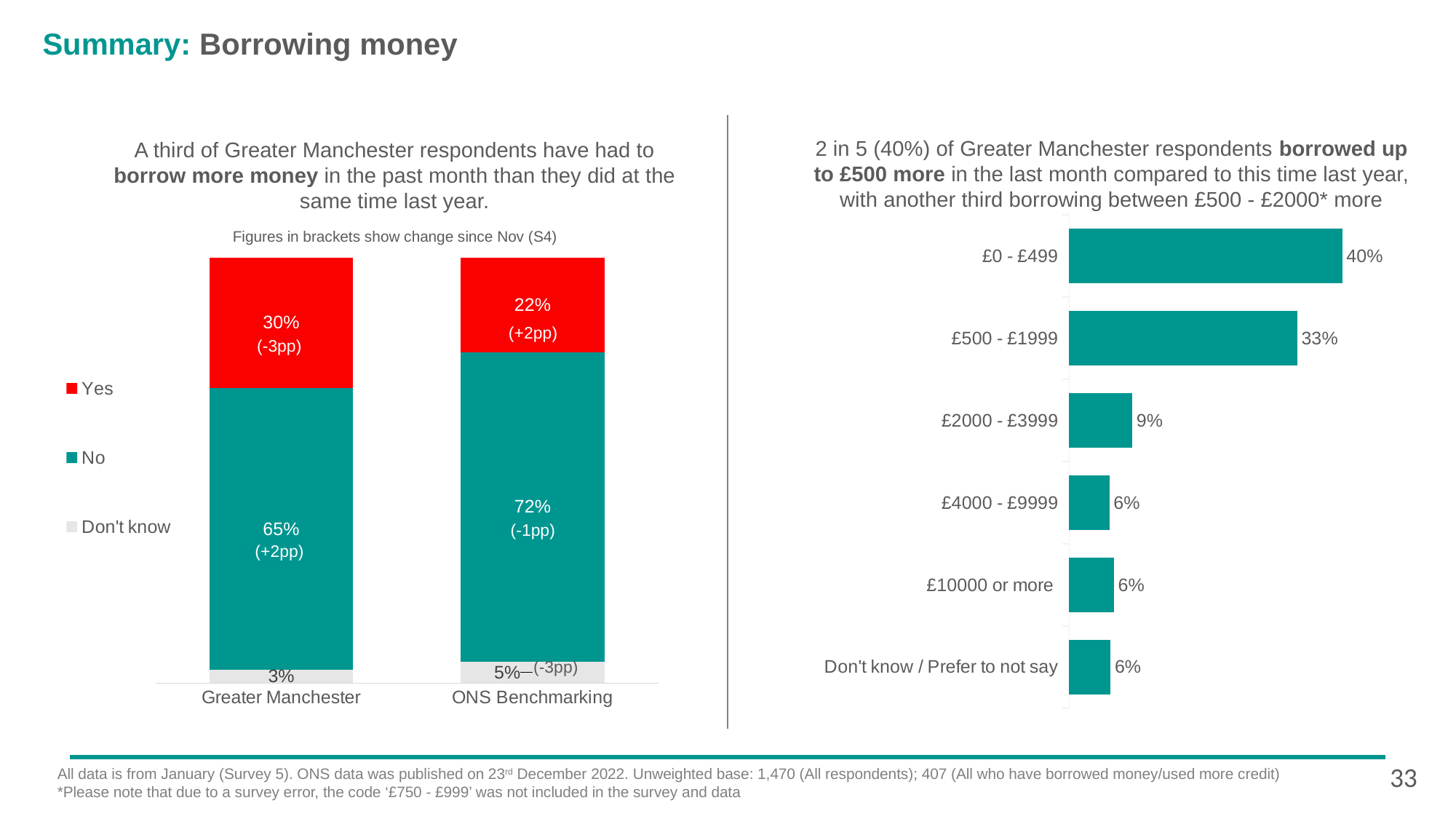
What type of chart is shown on the right of the slide? Bar chart In the stacked bar chart on the left, what is the Don't know percentage for ONS Benchmarking? 5% In the stacked bar chart on the left, which group has the larger Yes percentage, Greater Manchester or ONS Benchmarking? Greater Manchester In the bar chart on the right, what is the difference between the £0 - £499 and £500 - £1999 values? 7 percentage points In the bar chart on the right, how many categories are shown? 6 In the stacked bar chart on the left, what percentage of ONS Benchmarking respondents answered No? 72% In the bar chart on the right, what percentage of respondents borrowed £0 - £499 more? 40% In the bar chart on the right, which category has the highest value? £0 - £499 In the stacked bar chart on the left, what percentage of Greater Manchester respondents answered Yes? 30% In the stacked bar chart on the left, what colour represents the Yes series? Red In the stacked bar chart on the left, how many series does the legend list? 3 In the stacked bar chart on the left, what is the difference in percentage points between the No values for ONS Benchmarking and Greater Manchester? 7 percentage points